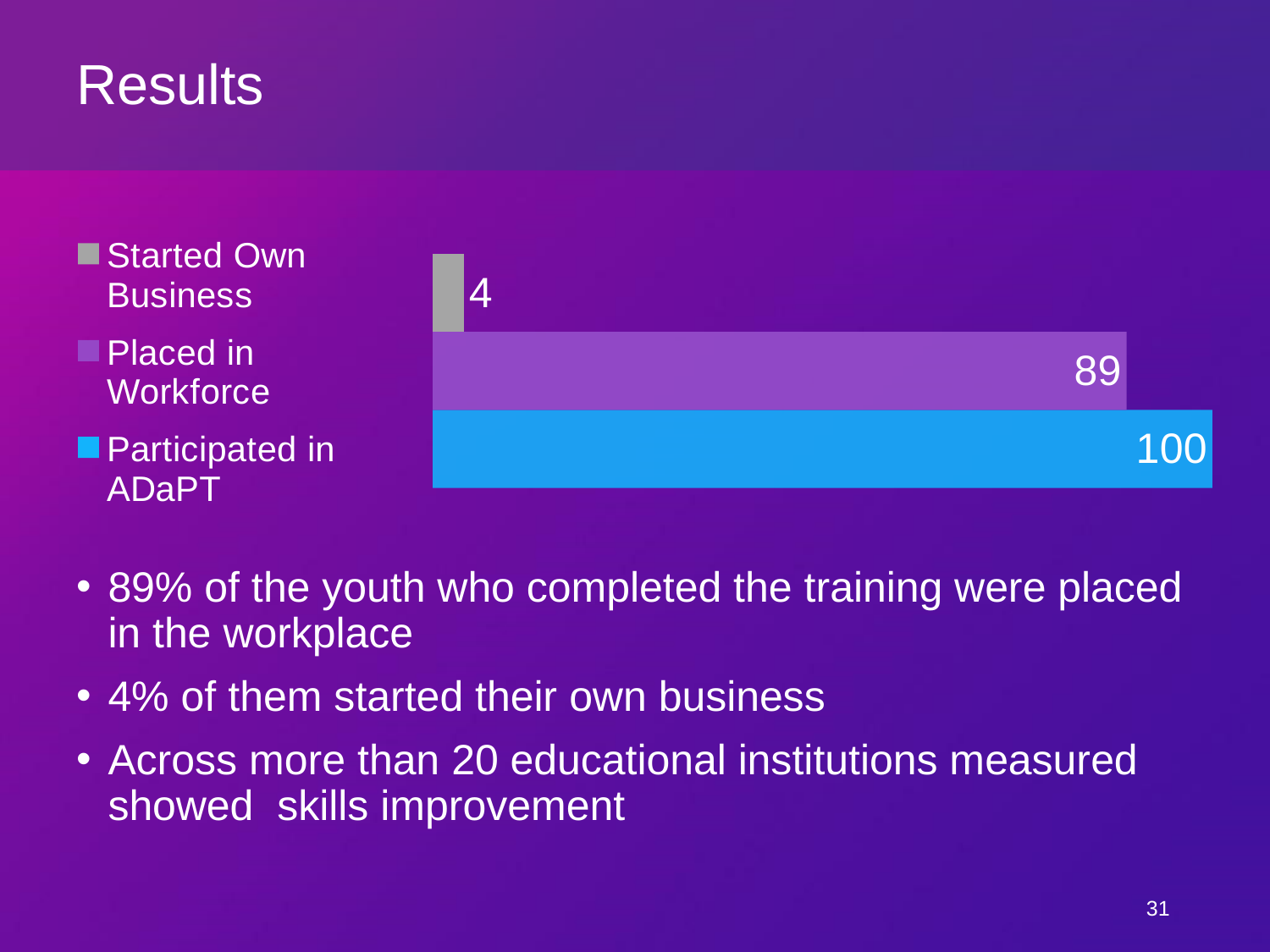
What is the difference between the values for Placed in Workforce and Started Own Business? 85 What colour is the bar for Participated in ADaPT? Blue What is the value for Started Own Business? 4 Which category has the lowest value? Started Own Business What kind of chart is shown on the slide? Bar chart What is the value for Placed in Workforce? 89 What colour is the bar for Started Own Business? Grey Which category has the highest value? Participated in ADaPT What is the difference between the values for Participated in ADaPT and Placed in Workforce? 11 How many series does the legend list? 3 What is the value for Participated in ADaPT? 100 Which is larger, the value for Placed in Workforce or the value for Started Own Business? Placed in Workforce